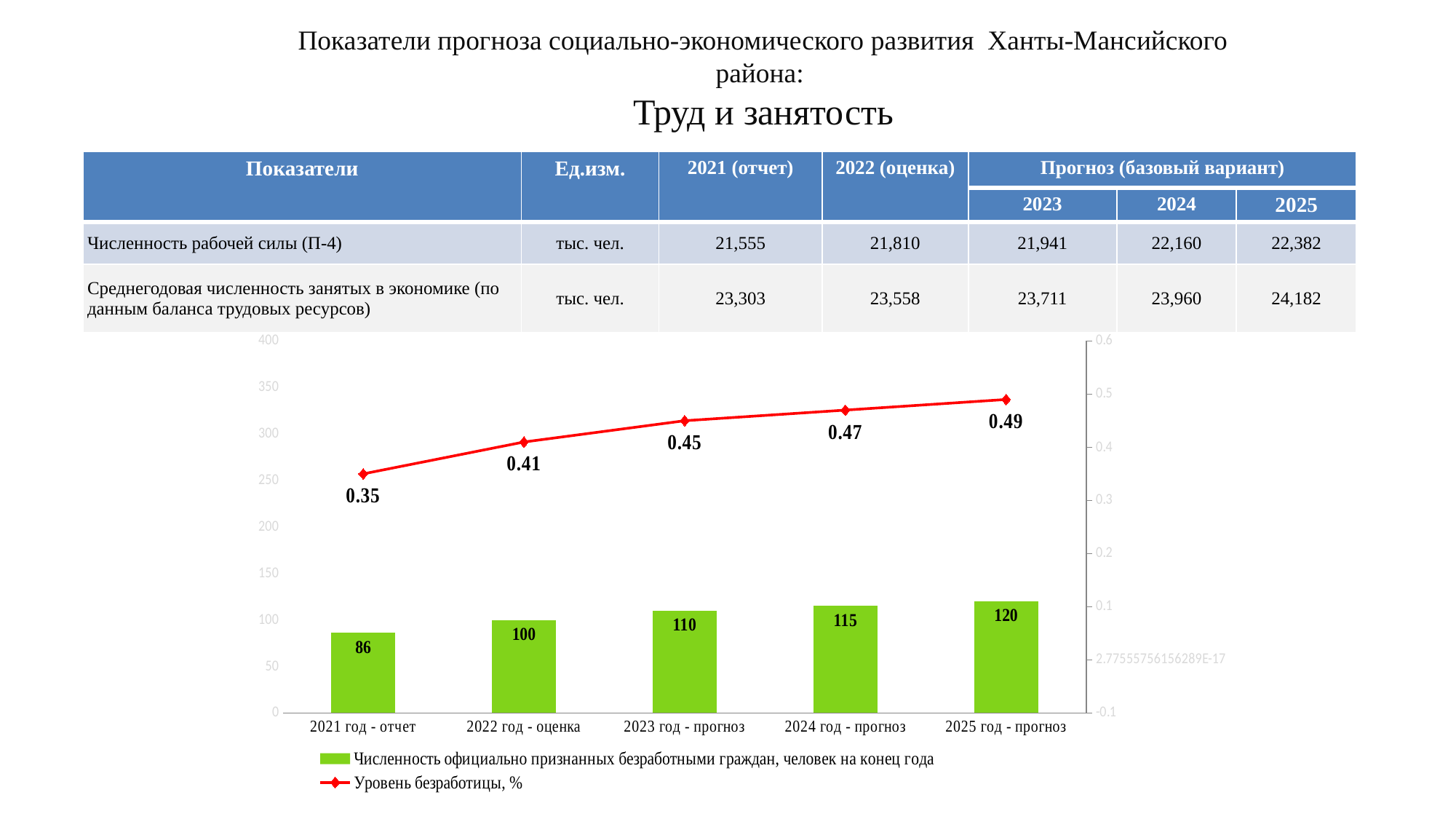
Which is larger: the bar value for 2023 год - прогноз or for 2024 год - прогноз? 2024 год - прогноз How many series does the legend list? 2 Which category has the highest bar value? 2025 год - прогноз What is the difference between the bar values for 2025 год - прогноз and 2021 год - отчет? 34 What colour are the bars in the chart? Green What kind of chart is shown on the slide? Combined bar and line chart Do the unemployment rate values rise or fall from 2021 to 2025? Rise How many categories are shown on the x axis? 5 What is the value of the bar for 2021 год - отчет? 86 What is the value of the bar for 2025 год - прогноз? 120 What is the unemployment rate (Уровень безработицы, %) shown for 2023 год - прогноз? 0.45 Which category has the lowest unemployment rate on the line? 2021 год - отчет